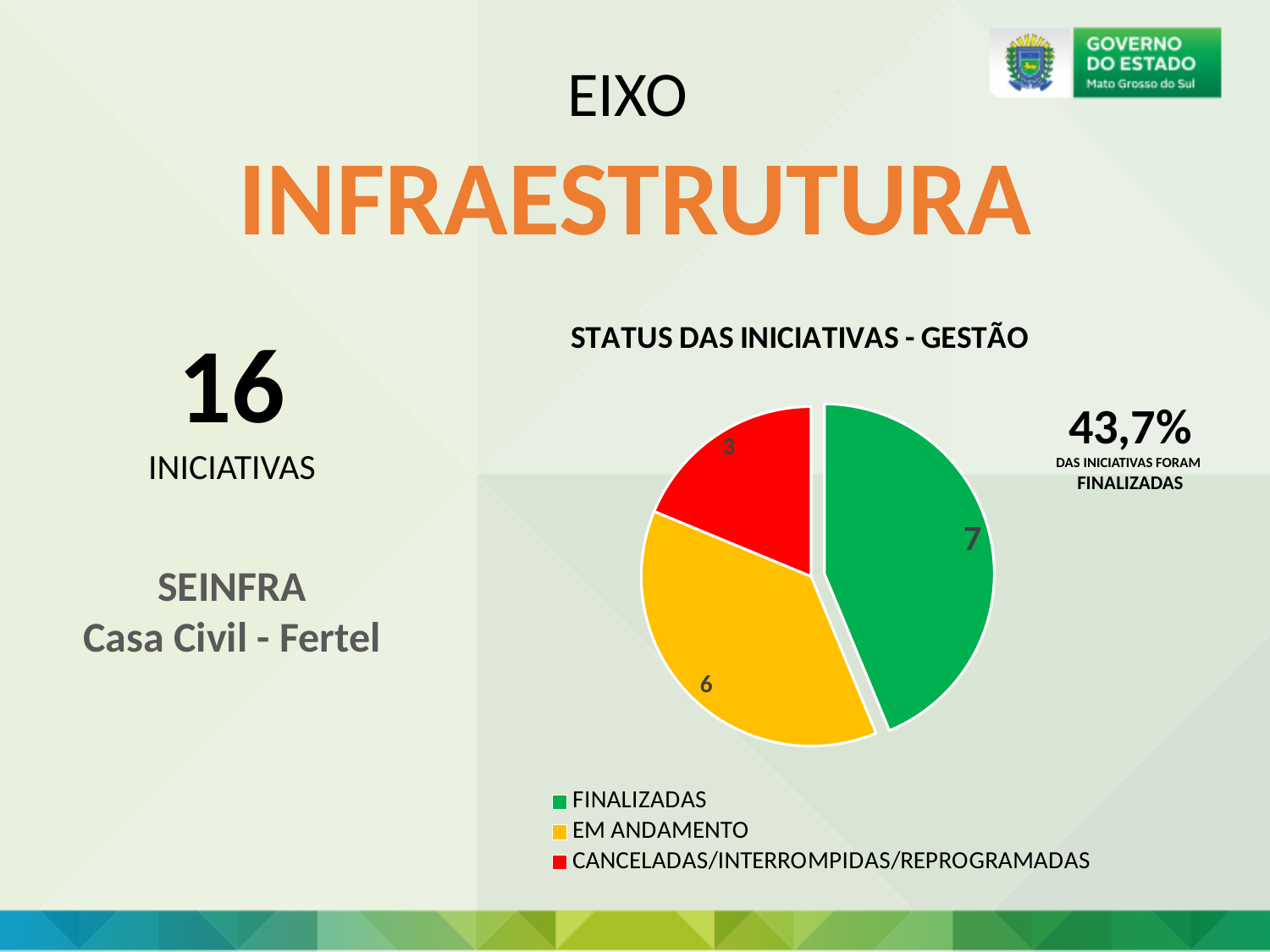
How many categories does the pie chart legend list? 3 What is the difference between the EM ANDAMENTO and CANCELADAS/INTERROMPIDAS/REPROGRAMADAS values in the pie chart? 3 What colour is the EM ANDAMENTO slice in the pie chart? Yellow What kind of chart is shown under the title "STATUS DAS INICIATIVAS - GESTÃO"? Pie chart Which category has the largest slice in the pie chart? FINALIZADAS How many initiatives are in the FINALIZADAS slice of the pie chart? 7 How many initiatives are in the CANCELADAS/INTERROMPIDAS/REPROGRAMADAS slice of the pie chart? 3 How many initiatives are in the EM ANDAMENTO slice of the pie chart? 6 What is the difference between the FINALIZADAS and EM ANDAMENTO values in the pie chart? 1 Which category has the smallest slice in the pie chart? CANCELADAS/INTERROMPIDAS/REPROGRAMADAS Which is larger in the pie chart, EM ANDAMENTO or CANCELADAS/INTERROMPIDAS/REPROGRAMADAS? EM ANDAMENTO What is the total of all slices in the pie chart? 16